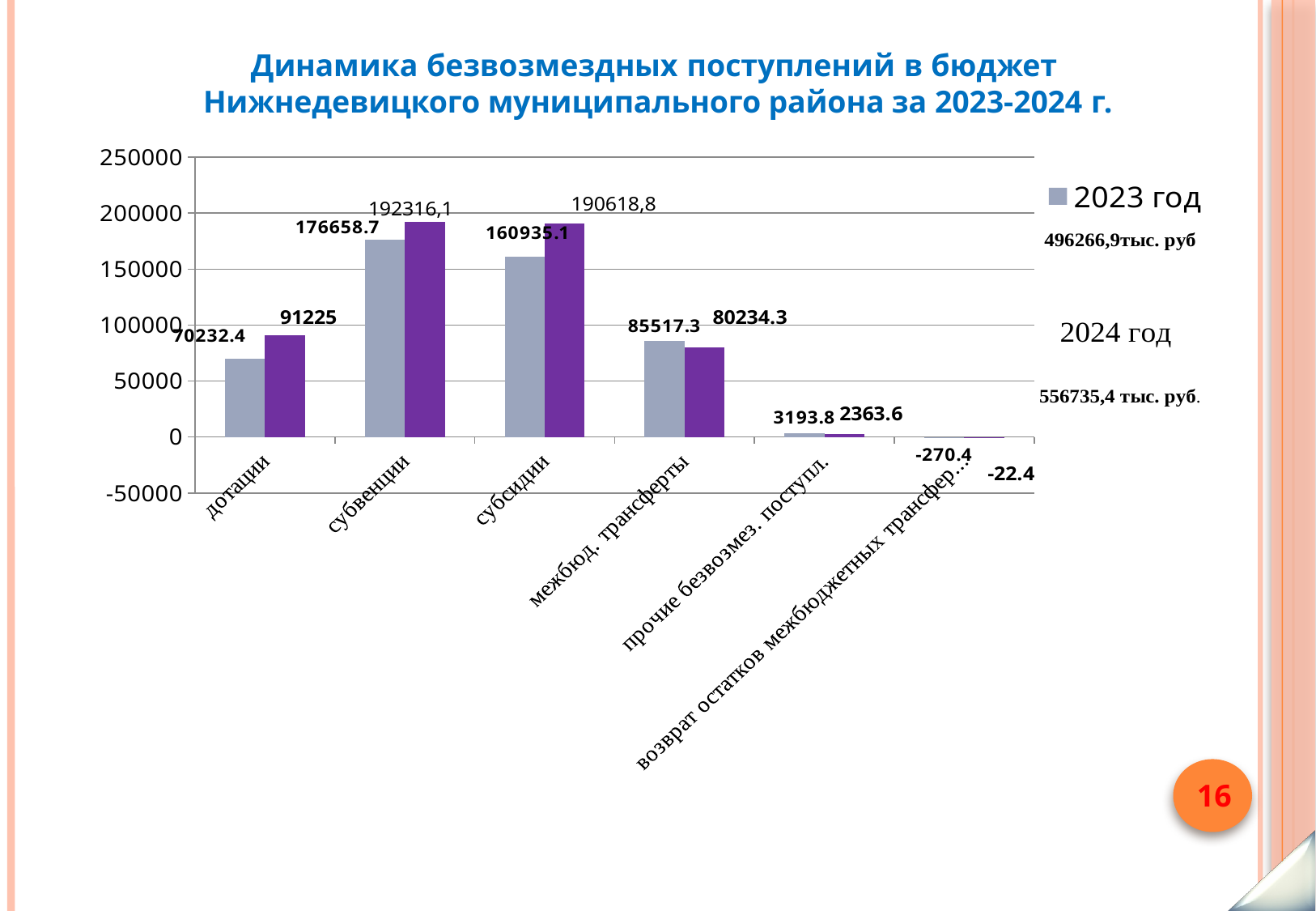
What kind of chart is shown on the slide? bar chart What is the difference between the 2023 год and 2024 год values for межбюд. трансферты? 5283 What is the value for субсидии in the 2024 год series? 190618,8 What is the value for межбюд. трансферты in the 2023 год series? 85517.3 How many series does the legend list? 2 What is the value for прочие безвозмез. поступл. in the 2024 год series? 2363.6 For субсидии, which series has the larger value, 2023 год or 2024 год? 2024 год What is the value for дотации in the 2023 год series? 70232.4 What is the difference between the 2024 год and 2023 год values for дотации? 20992.6 How many categories are shown on the x axis? 6 Which category has the lowest value in the 2024 год series? возврат остатков межбюджетных трансфер... Which category has the highest value in the 2023 год series? субвенции